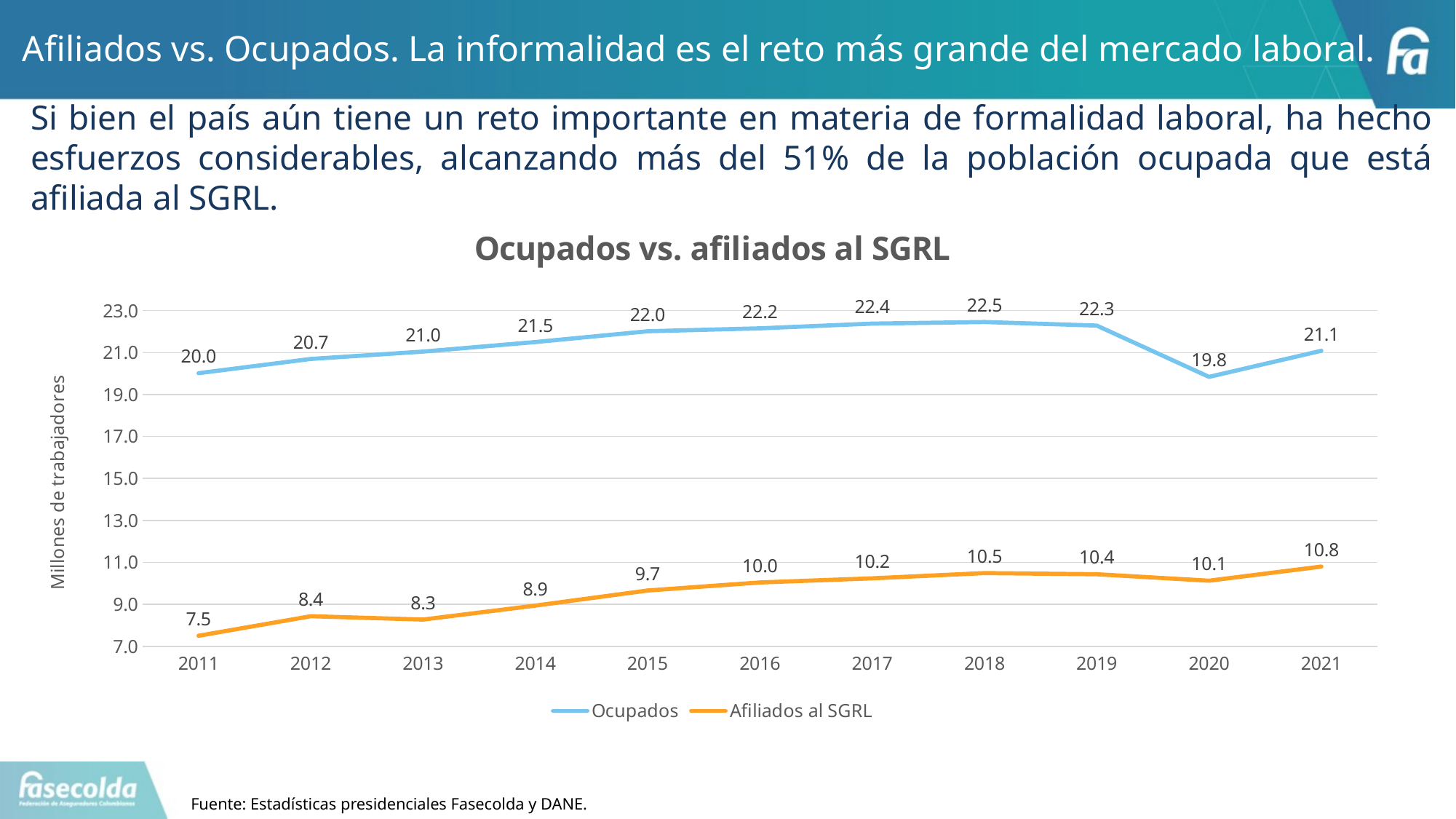
How many years are shown on the x axis? 11 What is the title of the chart? Ocupados vs. afiliados al SGRL Which is larger, the Ocupados value in 2019 or in 2020? 2019 What is the value for Ocupados in 2018? 22.5 What kind of chart is shown? Line chart In which year is the Ocupados series at its lowest? 2020 How many series does the legend list? 2 In which year is the Afiliados al SGRL series at its highest? 2021 Does the Afiliados al SGRL series rise or fall from 2011 to 2018? Rise What is the value for Afiliados al SGRL in 2011? 7.5 What is the value for Afiliados al SGRL in 2021? 10.8 What is the difference between Ocupados and Afiliados al SGRL in 2021? 10.3